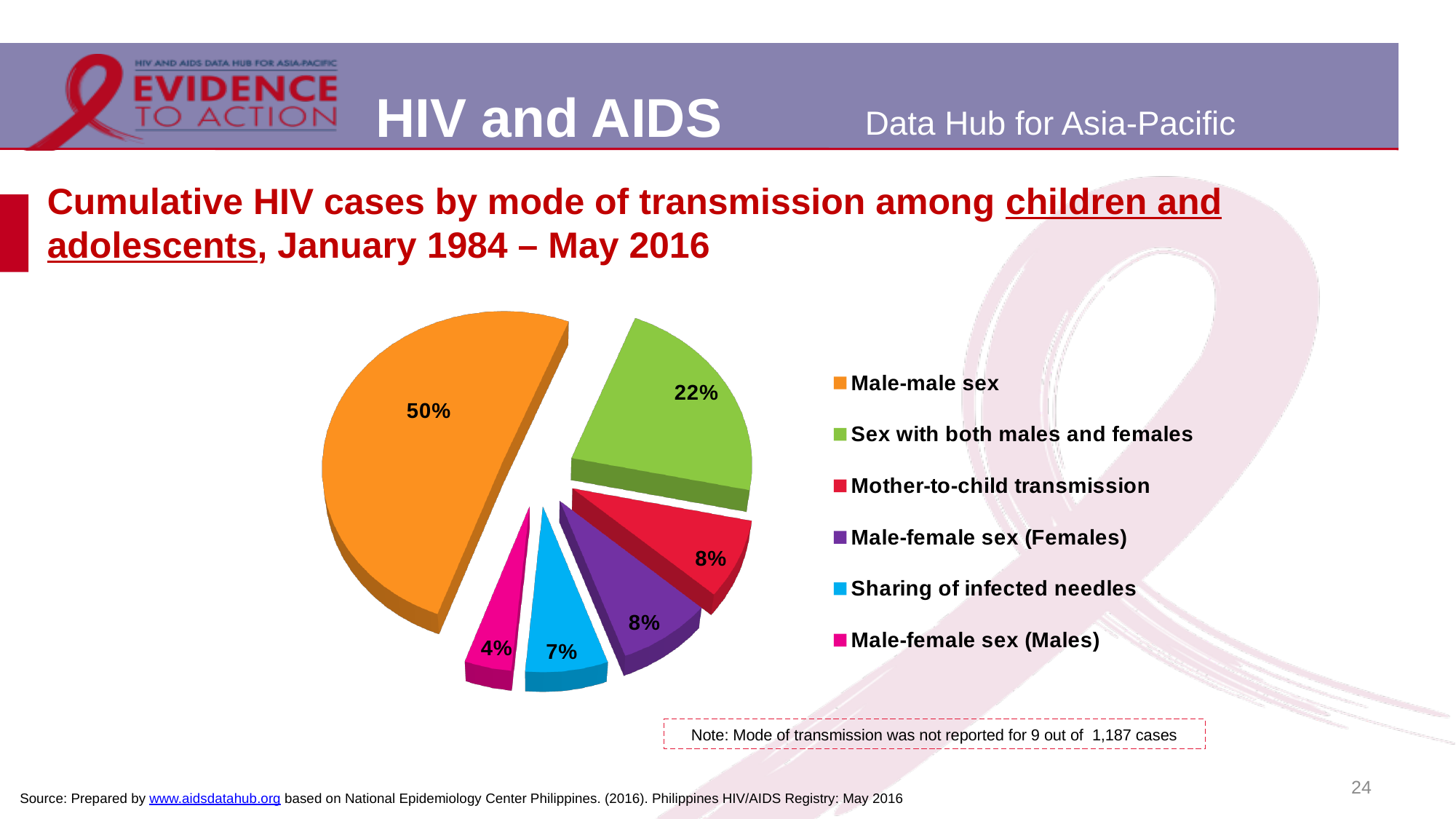
What share of cumulative HIV cases among children and adolescents is attributed to male-male sex? 50% What percentage of cases is attributed to mother-to-child transmission? 8% What percentage of cases is attributed to sex with both males and females? 22% What type of chart is used on this slide? Pie chart Which colour represents mother-to-child transmission in the chart? Red Which is larger: the share for sharing of infected needles or the share for male-female sex (Males)? Sharing of infected needles What percentage of cases is attributed to sharing of infected needles? 7% What is the difference in percentage points between male-male sex and sex with both males and females? 28 percentage points Which mode of transmission accounts for the smallest share of cases? Male-female sex (Males) What percentage of cases is attributed to male-female sex (Males)? 4% How many modes of transmission are shown in the pie chart? 6 Which mode of transmission accounts for the largest share of cases? Male-male sex